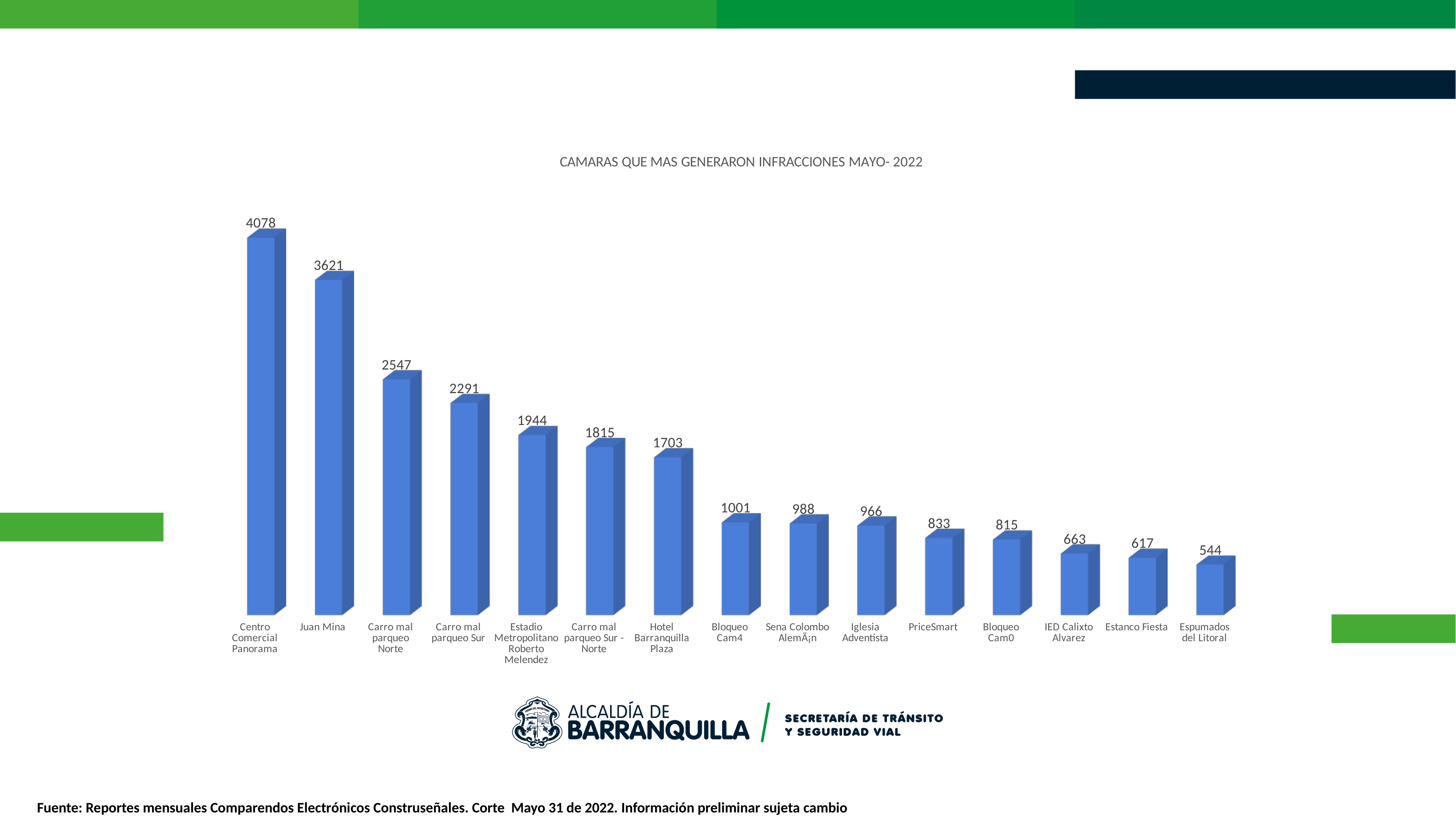
What is the value for PriceSmart? 833 Which camera has the highest value? Centro Comercial Panorama How many cameras are shown in the chart? 15 What is the value for Centro Comercial Panorama? 4078 What is the difference between Bloqueo Cam4 and Bloqueo Cam0? 186 Which is larger, Estadio Metropolitano Roberto Melendez or Carro mal parqueo Sur - Norte? Estadio Metropolitano Roberto Melendez What is the title of the chart? CAMARAS QUE MAS GENERARON INFRACCIONES MAYO- 2022 What is the difference between Juan Mina and Carro mal parqueo Norte? 1074 What kind of chart is this? bar chart What is the value for Hotel Barranquilla Plaza? 1703 Do the values rise or fall from left to right along the x axis? fall Which camera has the lowest value? Espumados del Litoral